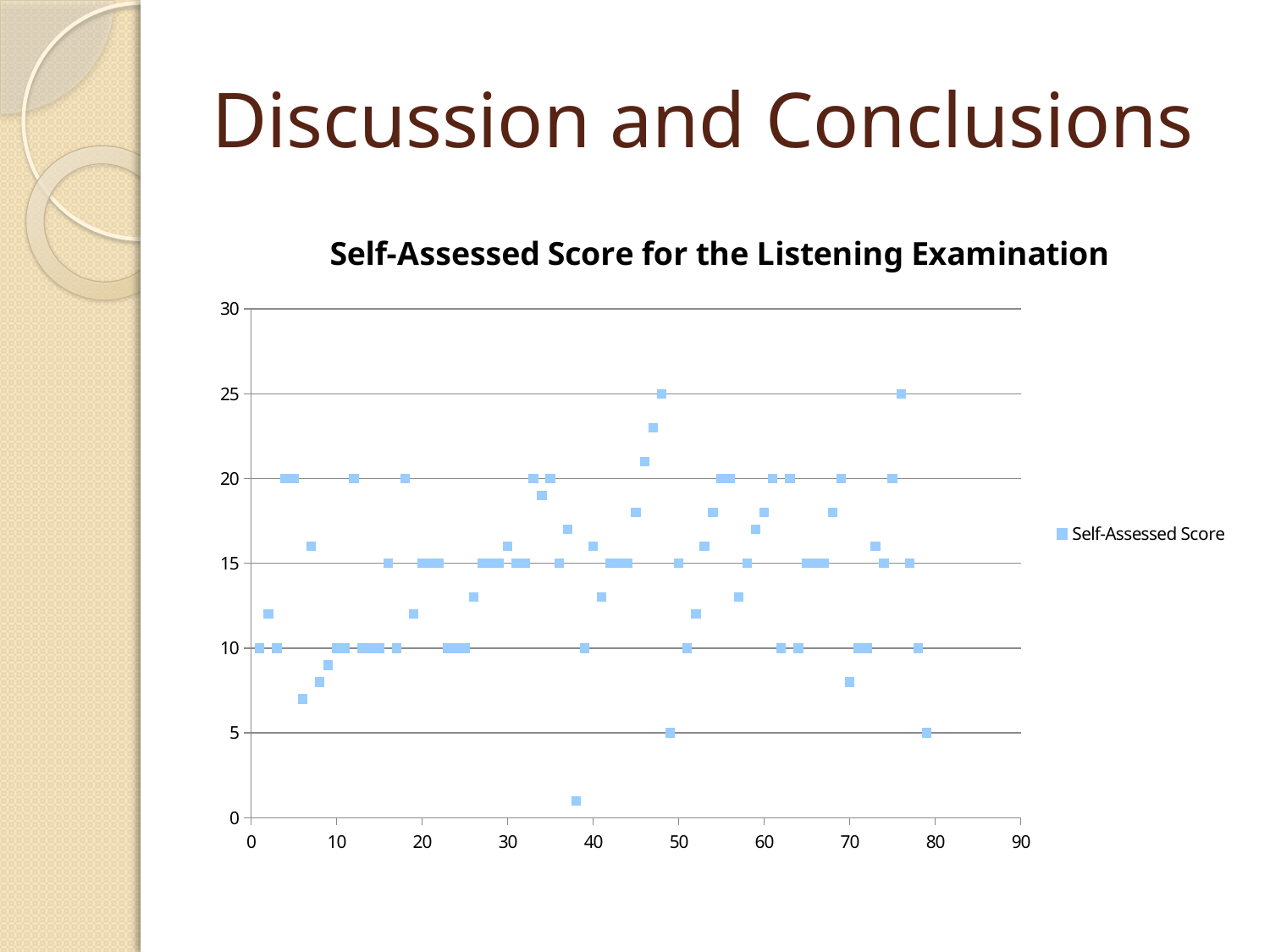
What is the title of the chart? Self-Assessed Score for the Listening Examination Is the lowest plotted self-assessed score greater or less than 5? less What is the maximum value shown on the vertical axis? 30 Is the highest plotted self-assessed score greater or less than 20? greater How many series does the legend list? 1 How many points reach the highest plotted value of 25? 2 What is the name of the series shown in the legend? Self-Assessed Score What is the highest self-assessed score plotted on the chart? 25 What kind of chart is shown on the slide? Scatter chart